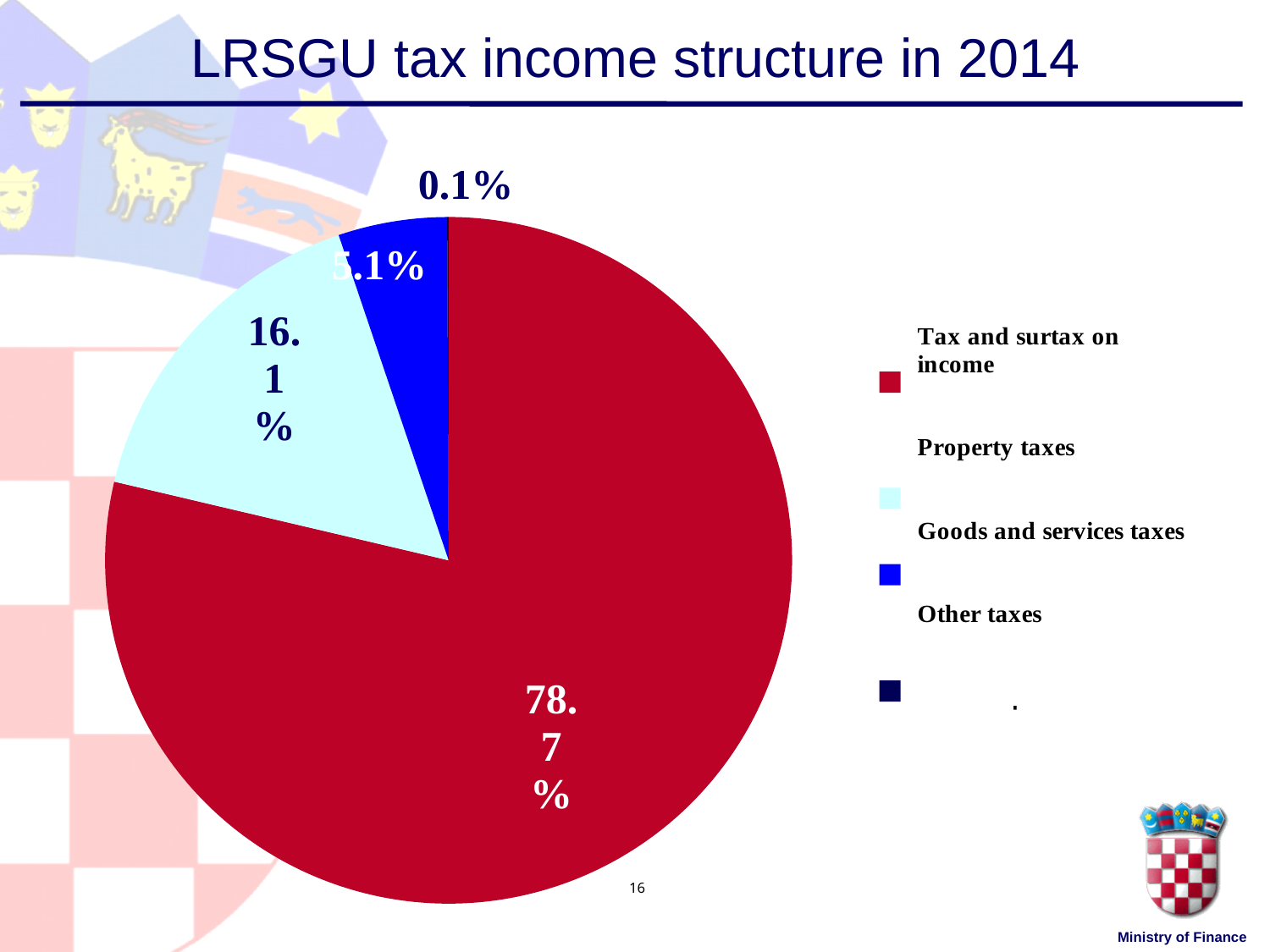
What share of the pie is Tax and surtax on income? 78.7% What share of the pie is Goods and services taxes? 5.1% Which is larger, the share for Property taxes or the share for Goods and services taxes? Property taxes What kind of chart is shown on the slide? pie chart What is the difference between the share for Tax and surtax on income and the share for Property taxes? 62.6% What is the title of the chart? LRSGU tax income structure in 2014 What colour is the slice for Tax and surtax on income? red What share of the pie is Other taxes? 0.1% Which category has the largest share of the pie? Tax and surtax on income Which category has the smallest share of the pie? Other taxes